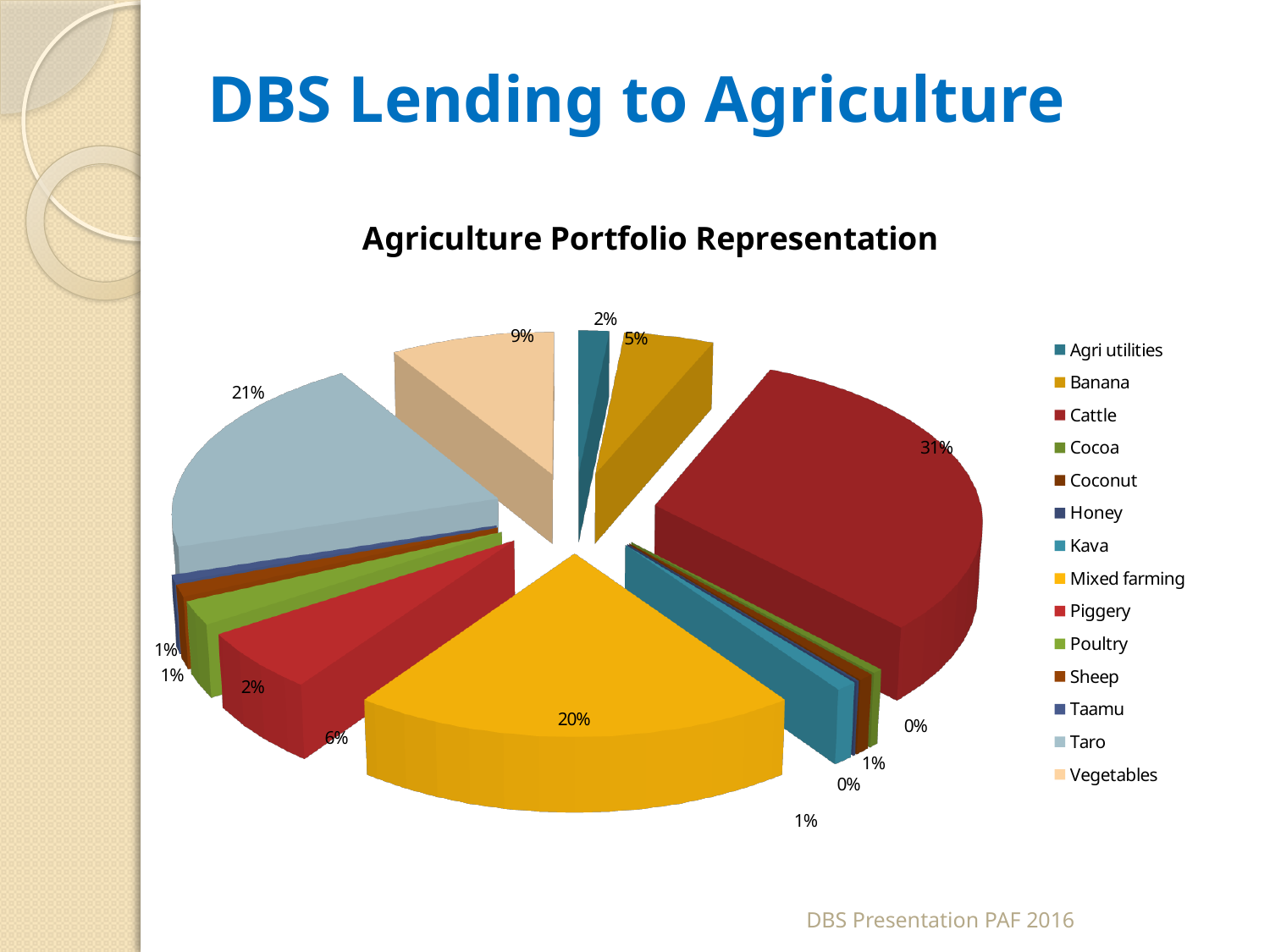
Which has the larger share, Taro or Mixed farming? Taro What share of the agriculture portfolio is Piggery? 6% What kind of chart is shown on the slide? Pie chart What share of the agriculture portfolio is Banana? 5% What share of the agriculture portfolio is Mixed farming? 20% Which category has the largest share of the agriculture portfolio? Cattle How many categories does the chart's legend list? 14 What is the title of the chart? Agriculture Portfolio Representation What share of the agriculture portfolio is Taro? 21% What share of the agriculture portfolio is Cattle? 31% What share of the agriculture portfolio is Vegetables? 9% By how many percentage points does Cattle's share exceed Taro's share? 10 percentage points